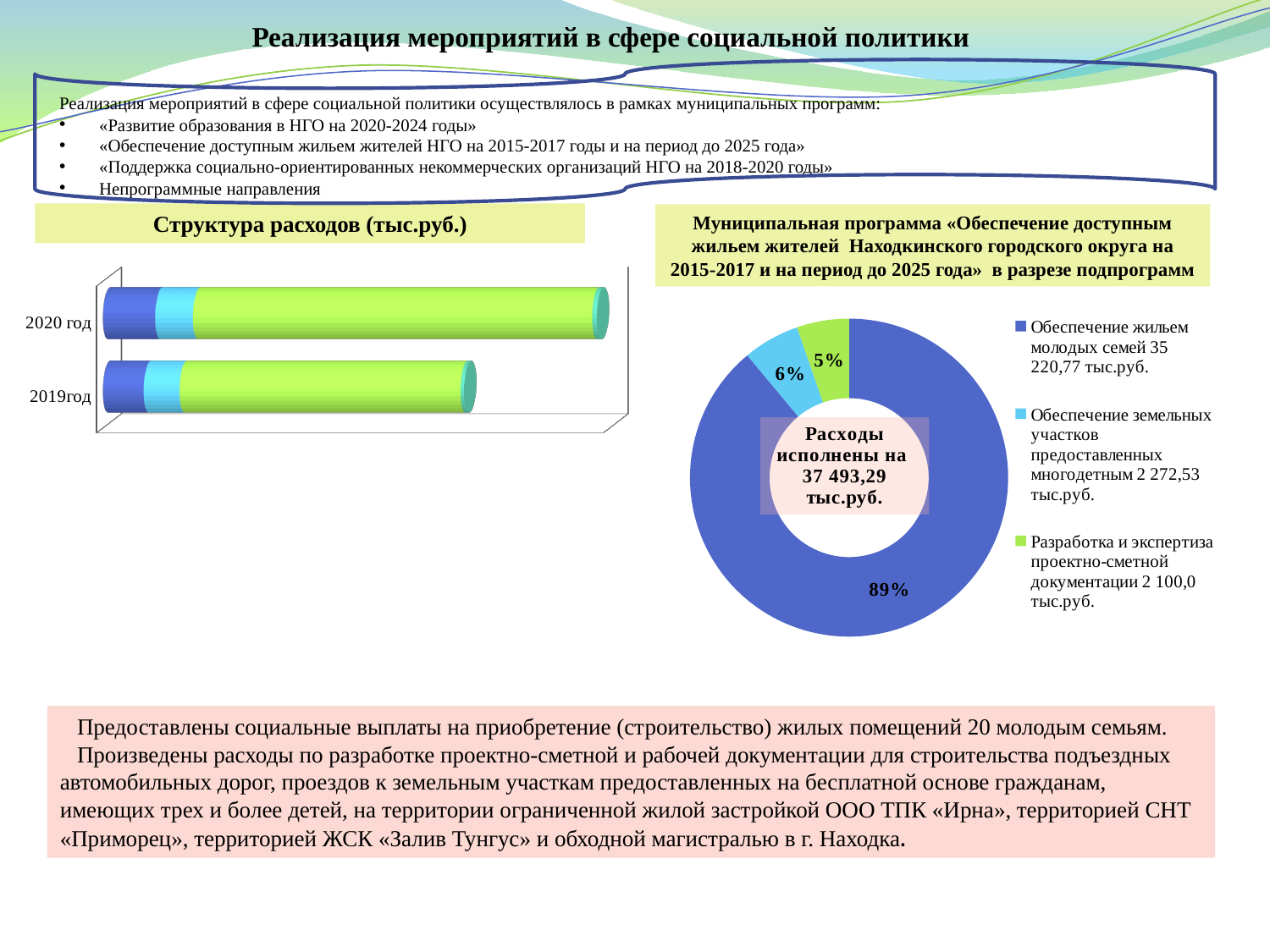
In the doughnut chart on the right, what amount in тыс.руб. does the legend give for 'Обеспечение жильем молодых семей'? 35 220,77 тыс.руб. In the 'Структура расходов (тыс.руб.)' bar chart, which year has the longer bar, 2020 год or 2019год? 2020 год How many years are shown on the 'Структура расходов (тыс.руб.)' bar chart? 2 What kind of chart is the 'Структура расходов (тыс.руб.)' chart on the left? Bar chart In the doughnut chart on the right, which subprogram has the smallest share? Разработка и экспертиза проектно-сметной документации In the doughnut chart on the right, what share is shown for 'Разработка и экспертиза проектно-сметной документации'? 5% In the doughnut chart on the right, what share is shown for 'Обеспечение жильем молодых семей'? 89% In the doughnut chart on the right, what share is shown for 'Обеспечение земельных участков предоставленных многодетным'? 6% In the doughnut chart on the right, what amount in тыс.руб. does the legend give for 'Разработка и экспертиза проектно-сметной документации'? 2 100,0 тыс.руб. According to the text in the centre of the doughnut chart on the right, what is the total amount of expenses executed? 37 493,29 тыс.руб. What kind of chart is used for the 'Муниципальная программа «Обеспечение доступным жильем...»' chart on the right? Doughnut (pie) chart In the doughnut chart on the right, which subprogram has the largest share? Обеспечение жильем молодых семей